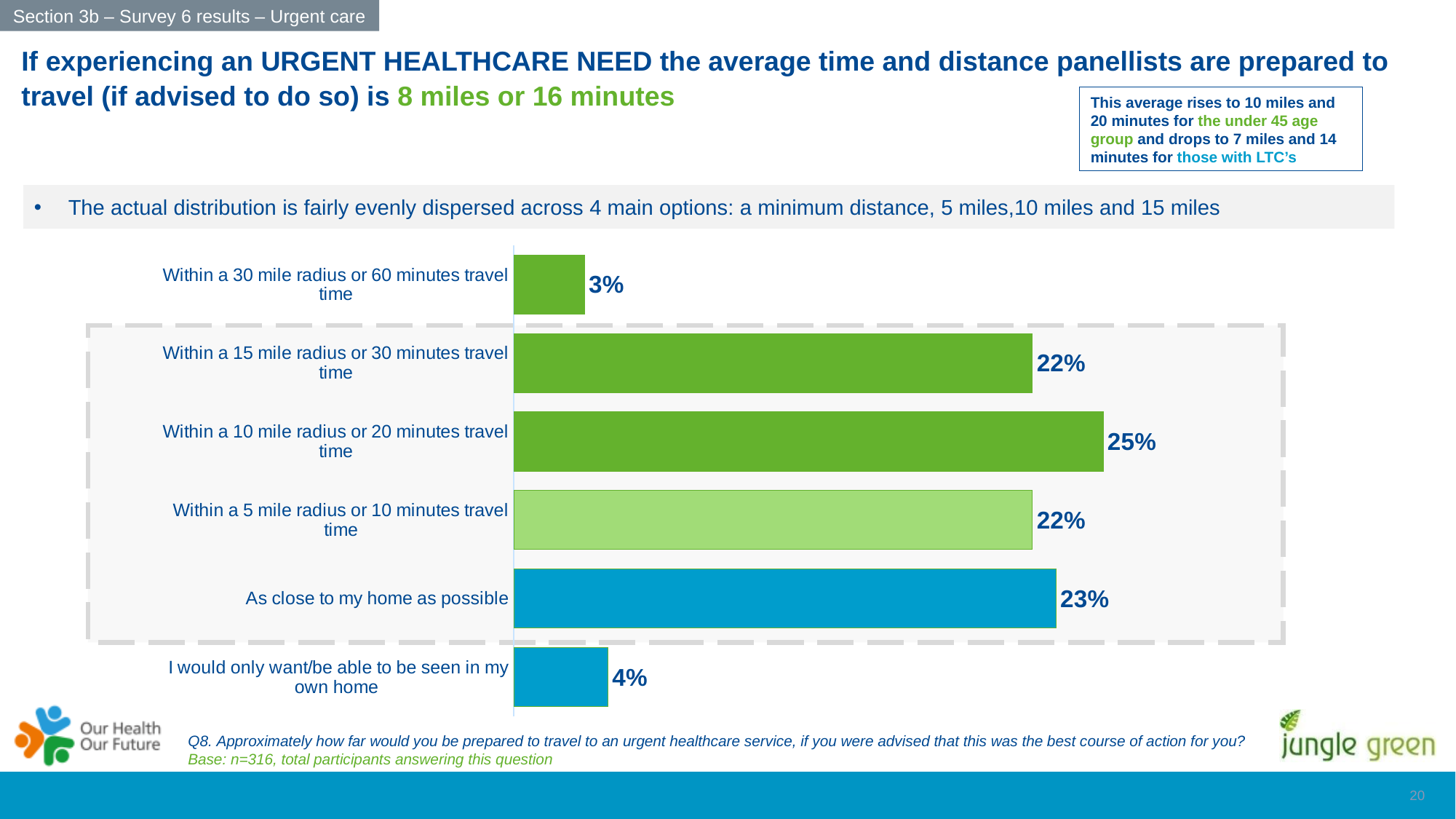
What percentage of panellists would travel within a 30 mile radius or 60 minutes travel time? 3% How many options (categories) are shown in the chart? 6 What percentage of panellists would only want/be able to be seen in their own home? 4% What percentage of panellists would travel within a 10 mile radius or 20 minutes travel time? 25% Which is larger: the percentage for 'As close to my home as possible' or for 'Within a 15 mile radius or 30 minutes travel time'? As close to my home as possible What type of chart is shown on the slide? Bar chart What is the difference in percentage points between 'Within a 10 mile radius or 20 minutes travel time' and 'Within a 30 mile radius or 60 minutes travel time'? 22 percentage points Which option has the lowest percentage of panellists? Within a 30 mile radius or 60 minutes travel time What percentage of panellists chose 'As close to my home as possible'? 23% Which option has the highest percentage of panellists? Within a 10 mile radius or 20 minutes travel time What is the base (number of participants) for the question shown in the chart? n=316 What is the combined percentage for 'Within a 5 mile radius or 10 minutes travel time' and 'Within a 15 mile radius or 30 minutes travel time'? 44%